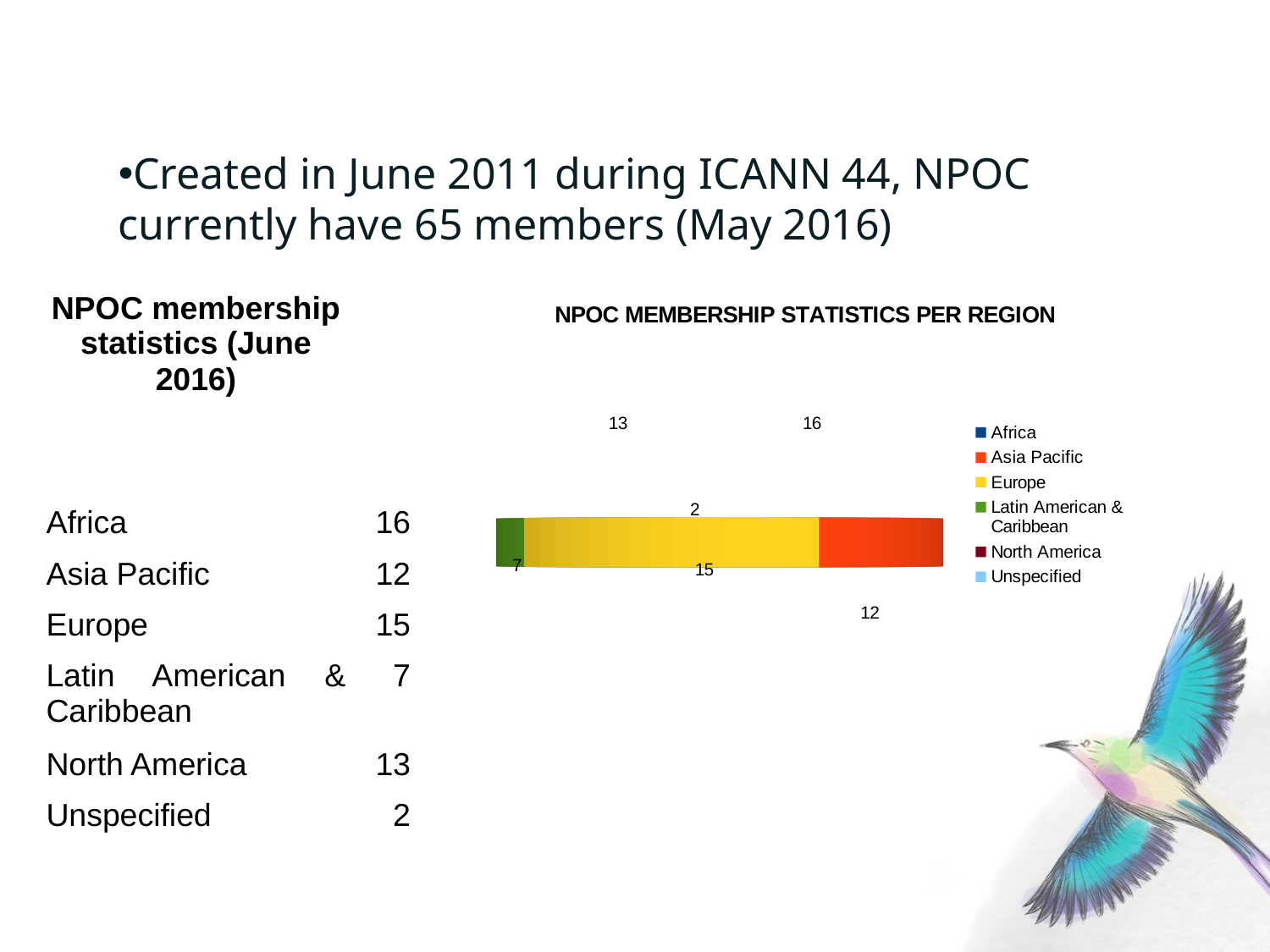
Which has a larger membership value, North America or Europe? Europe Which colour represents Asia Pacific in the chart's legend? Red What is the membership value shown for Unspecified? 2 What is the membership value shown for Latin American & Caribbean? 7 How many regions does the chart's legend list? 6 What is the membership value shown for Africa? 16 Which region has the highest membership value? Africa What is the total of all the membership values shown in the chart? 65 What is the difference between the membership values for Africa and Asia Pacific? 4 Which region has the lowest membership value? Unspecified What is the membership value shown for Europe? 15 What is the title of the chart on the right side of the slide? NPOC MEMBERSHIP STATISTICS PER REGION